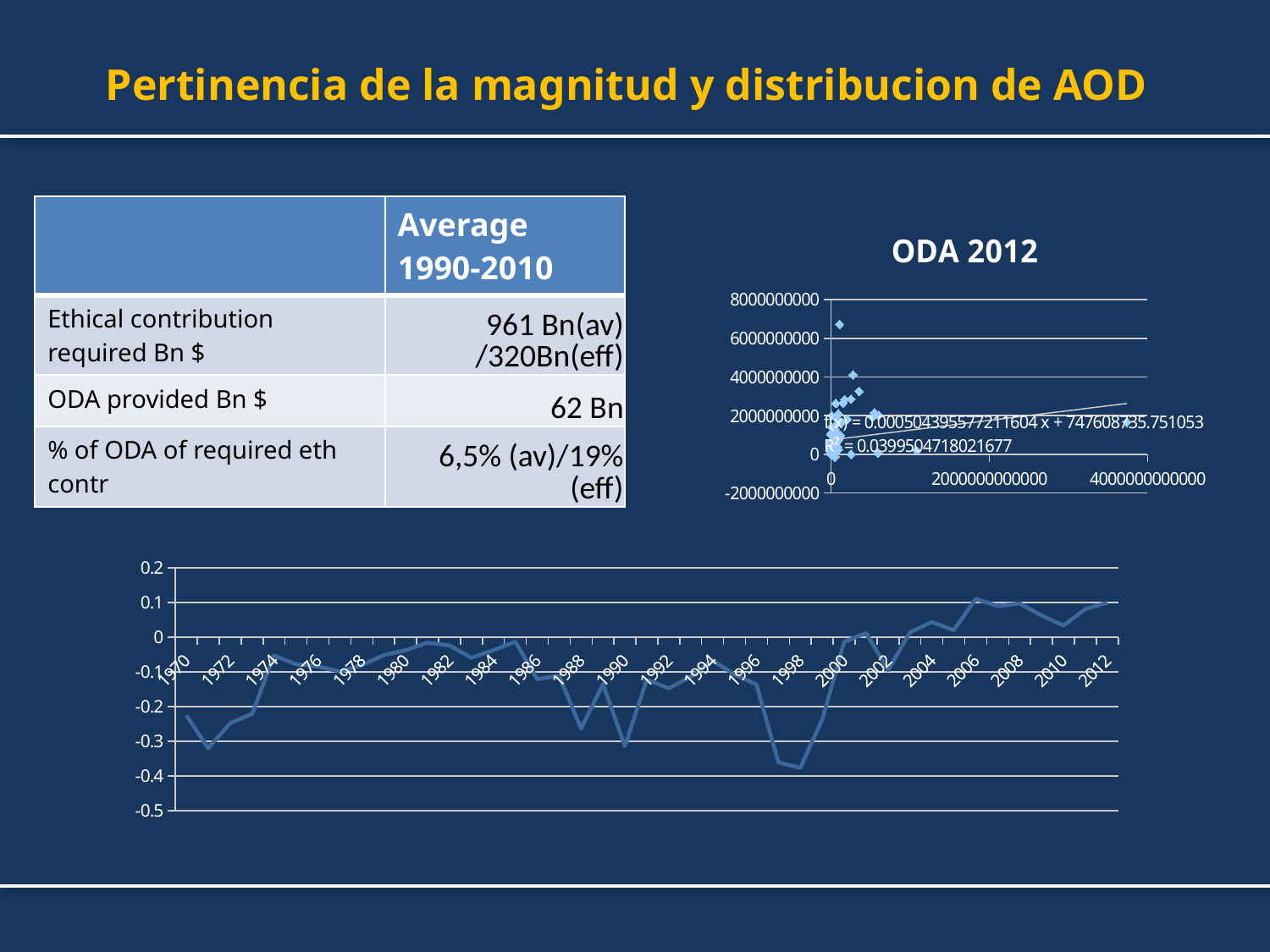
In the chart titled "ODA 2012", what is the highest value shown on the vertical axis? 8000000000 In the bottom line chart, do the values overall rise or fall from 1970 to 2012? rise In the bottom line chart, is the value for 2012 greater or less than 0? greater What kind of chart is the chart titled "ODA 2012"? scatter chart What kind of chart is the chart at the bottom of the slide? line chart In the bottom line chart, is the value for 1998 greater or less than -0.3? less In the bottom line chart, is the value for 1971 greater or less than -0.2? less In the bottom line chart, what is the first year shown on the x axis? 1970 In the chart titled "ODA 2012", what R² value is printed on the chart? R² = 0.0399504718021677 In the bottom line chart, which year has the larger value, 1998 or 2006? 2006 In the bottom line chart, which year has the larger value, 1971 or 1980? 1980